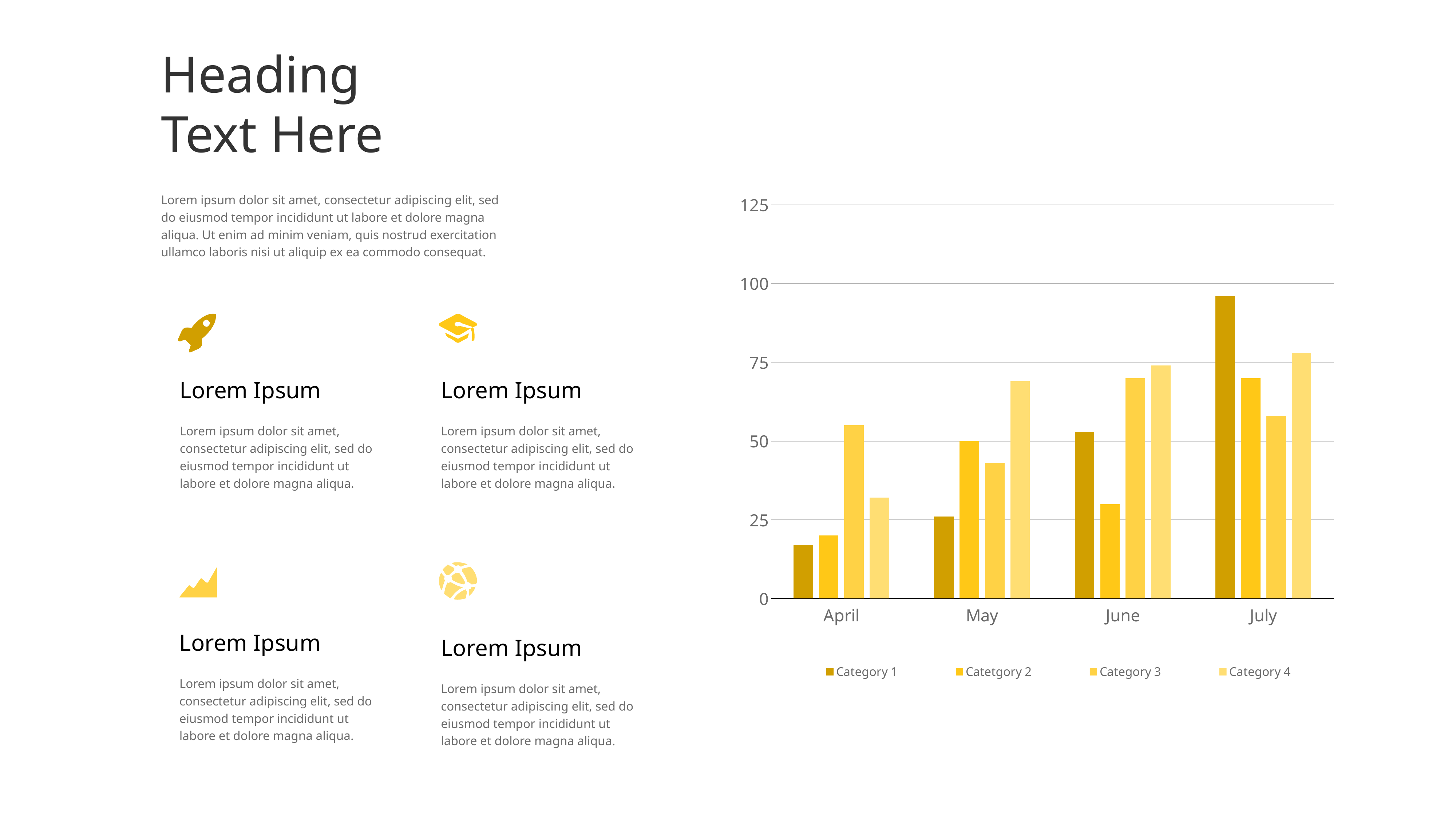
Which month has the lowest value for Category 1? April Which month has the highest value for Category 1? July What kind of chart is shown on the slide? bar chart Which month has the lowest value for Catetgory 2? April How many series does the chart's legend list? 4 Is the value for Category 4 in May greater or less than 50? greater Is the value for Category 1 in July greater or less than 75? greater In April, which is larger: Category 3 or Category 4? Category 3 Which month has the highest value for Category 3? June How many months are shown on the x axis of the chart? 4 Do the values for Category 1 rise or fall from April to July? rise Is the value for Category 1 in May greater or less than 50? less